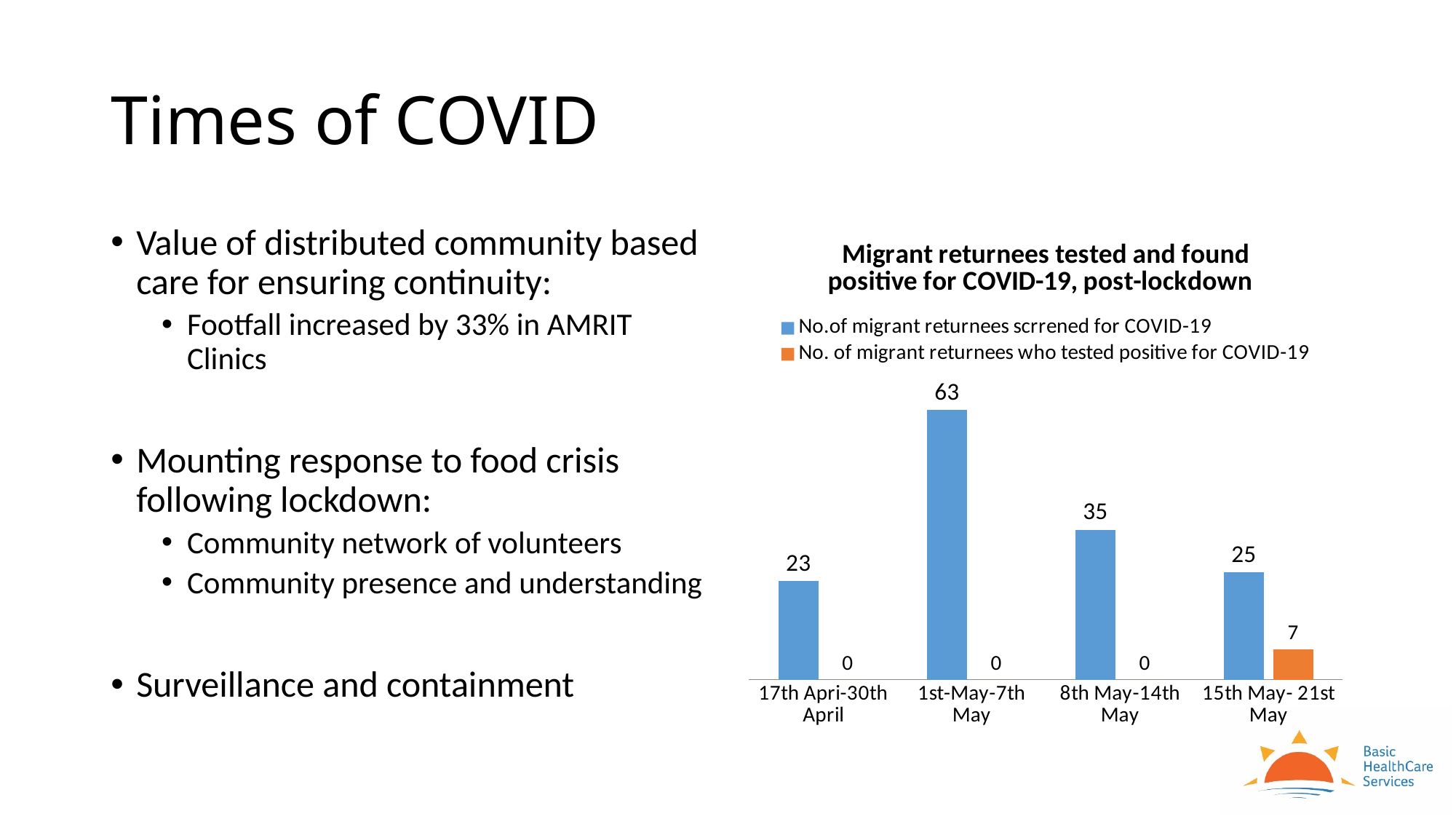
How many migrant returnees tested positive for COVID-19 in the period 15th May- 21st May? 7 How many migrant returnees were screened for COVID-19 in the period 17th Apri-30th April? 23 What is the title of the chart? Migrant returnees tested and found positive for COVID-19, post-lockdown What is the difference between the number screened in 1st-May-7th May and the number screened in 8th May-14th May? 28 How many series does the chart legend list? 2 Which period had the lowest number of migrant returnees screened for COVID-19? 17th Apri-30th April How many time periods are shown on the x axis of the chart? 4 Which is larger: the number screened in 8th May-14th May or in 15th May- 21st May? 8th May-14th May Which period had the highest number of migrant returnees screened for COVID-19? 1st-May-7th May What type of chart is shown on the slide? Bar chart How many migrant returnees were screened for COVID-19 in the period 1st-May-7th May? 63 Which colour represents the number of migrant returnees who tested positive for COVID-19? Orange